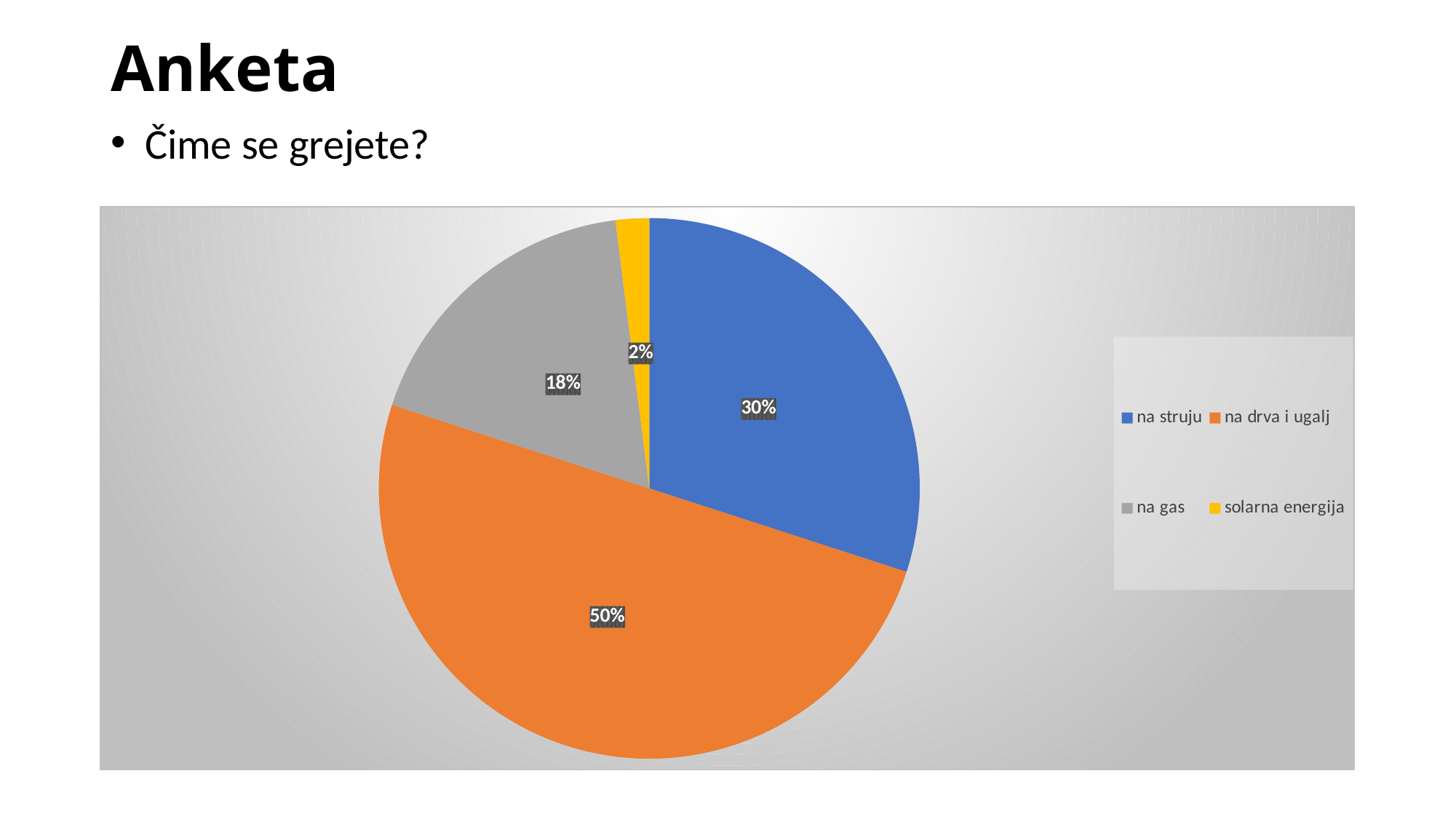
Which is larger, the slice for 'na gas' or the slice for 'na struju'? na struju How many categories does the pie chart show? 4 What share of the pie is 'solarna energija'? 2% What kind of chart is shown on the slide? pie chart Which category has the largest slice of the pie? na drva i ugalj What share of the pie is 'na struju'? 30% What share of the pie is 'na drva i ugalj'? 50% What share of the pie is 'na gas'? 18% What colour is the slice for 'na gas'? grey Which category has the smallest slice of the pie? solarna energija What question is written above the chart as the bullet point? Čime se grejete? What is the difference in percentage points between 'na drva i ugalj' and 'na struju'? 20